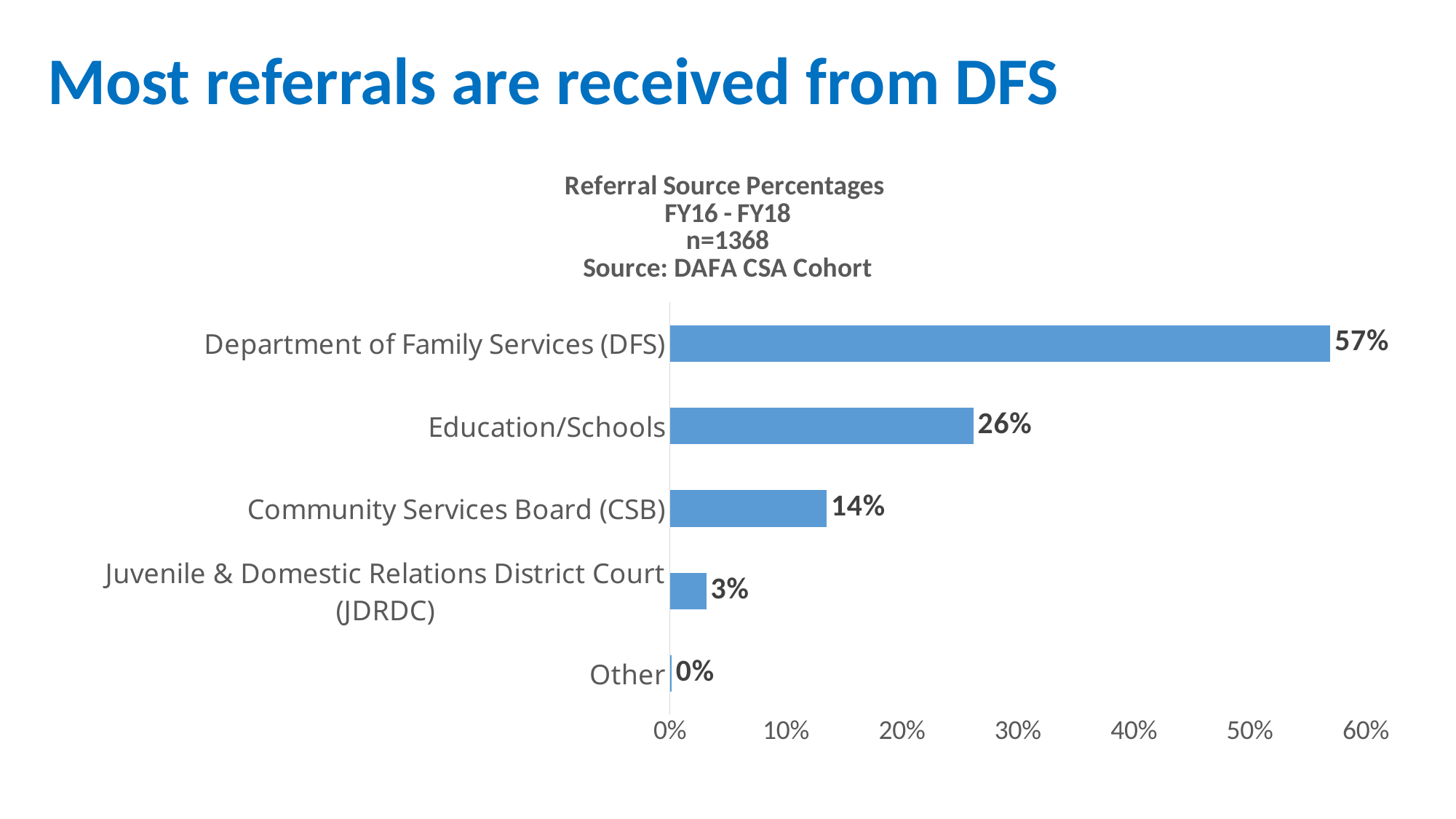
What is the difference in percentage points between Department of Family Services (DFS) and Education/Schools? 31% Which has a larger referral percentage, Education/Schools or Community Services Board (CSB)? Education/Schools What is the sample size (n) stated in the chart title? n=1368 What is the referral percentage for Education/Schools? 26% Which referral source has the highest percentage? Department of Family Services (DFS) How many referral source categories are shown in the chart? 5 Is the value for Department of Family Services (DFS) greater or less than 50%? greater What is the referral percentage for Community Services Board (CSB)? 14% Which referral source has the lowest percentage? Other What is the referral percentage for Juvenile & Domestic Relations District Court (JDRDC)? 3% What percentage of referrals come from the Department of Family Services (DFS)? 57% What type of chart is shown on the slide? Bar chart